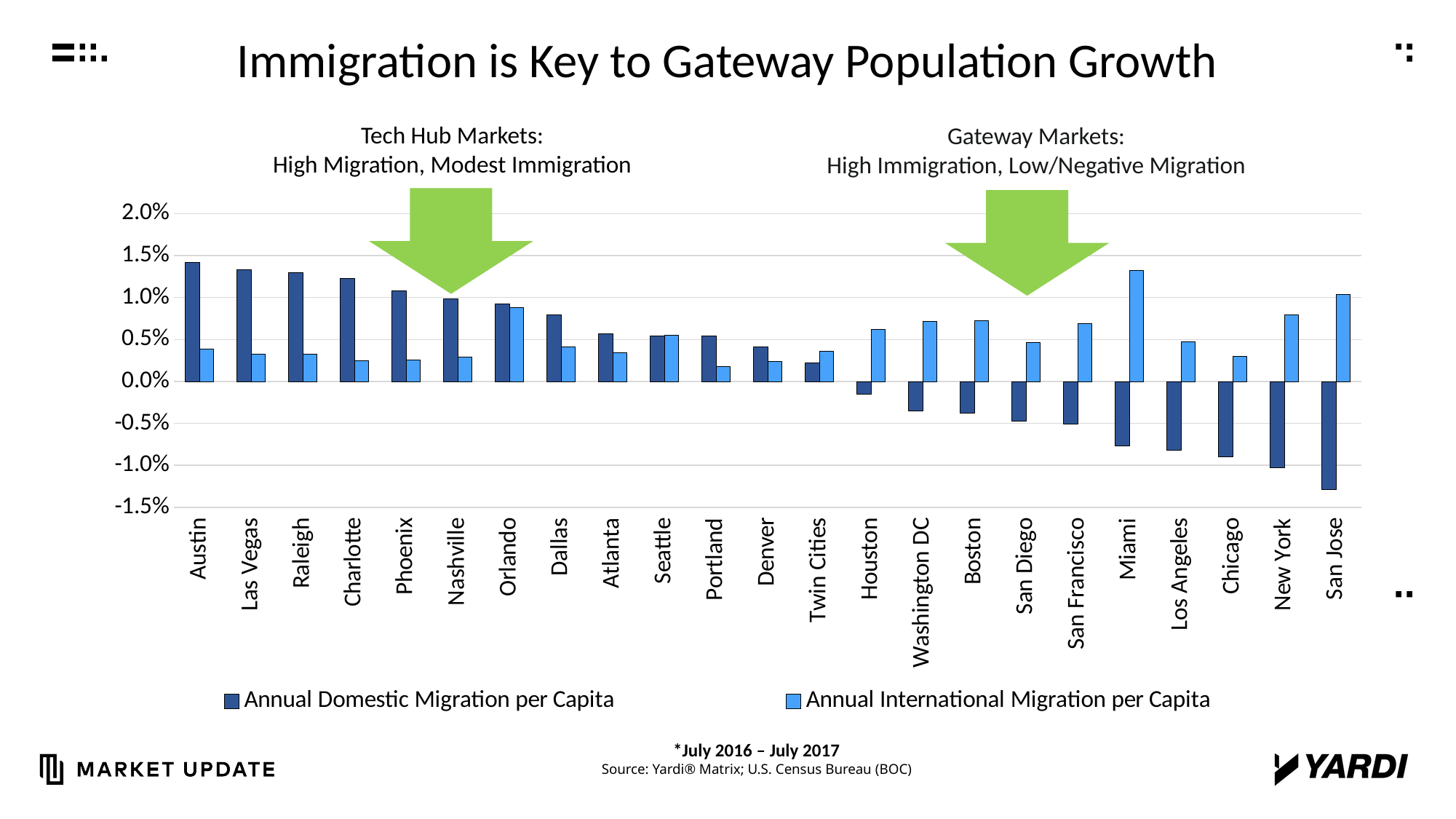
For New York, which is larger: Annual Domestic Migration per Capita or Annual International Migration per Capita? Annual International Migration per Capita Is the Annual International Migration per Capita for Miami greater or less than 1.0%? greater How many markets are shown on the x axis? 23 What kind of chart is shown on the slide? bar chart Which market has the highest Annual International Migration per Capita? Miami Is the Annual Domestic Migration per Capita for Austin greater or less than 1.0%? greater Which market has the lowest Annual International Migration per Capita? Portland Which market has the lowest Annual Domestic Migration per Capita? San Jose Is the Annual Domestic Migration per Capita for Chicago greater or less than -0.5%? less Does Annual Domestic Migration per Capita generally rise or fall moving from Austin on the left to San Jose on the right? fall How many series does the legend list? 2